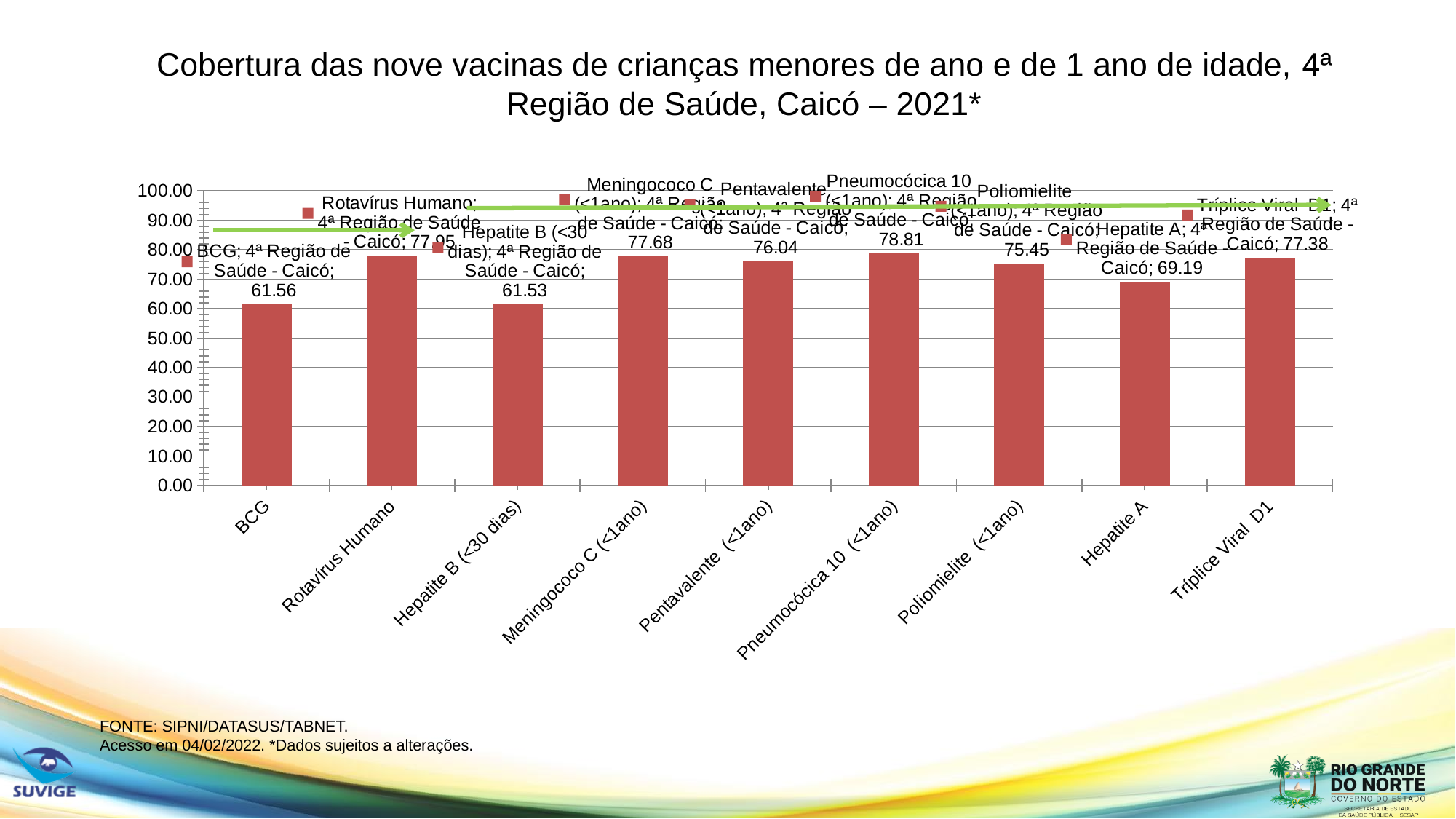
Which has a higher coverage value, Meningococo C (<1ano) or Pentavalente (<1ano)? Meningococo C (<1ano) What is the coverage value shown for BCG? 61.56 What is the coverage value shown for Hepatite B (<30 dias)? 61.53 What source is cited for the chart data? SIPNI/DATASUS/TABNET What is the coverage value shown for Pneumocócica 10 (<1ano)? 78.81 What kind of chart is shown on the slide? bar chart What is the difference between the coverage values for Pneumocócica 10 (<1ano) and Hepatite A? 9.62 Which vaccine has the highest coverage value in the chart? Pneumocócica 10 (<1ano) Is the value for Poliomielite (<1ano) greater or less than 80? less What is the coverage value shown for Tríplice Viral D1? 77.38 How many vaccines are shown as bars in the chart? 9 What is the coverage value shown for Hepatite A? 69.19